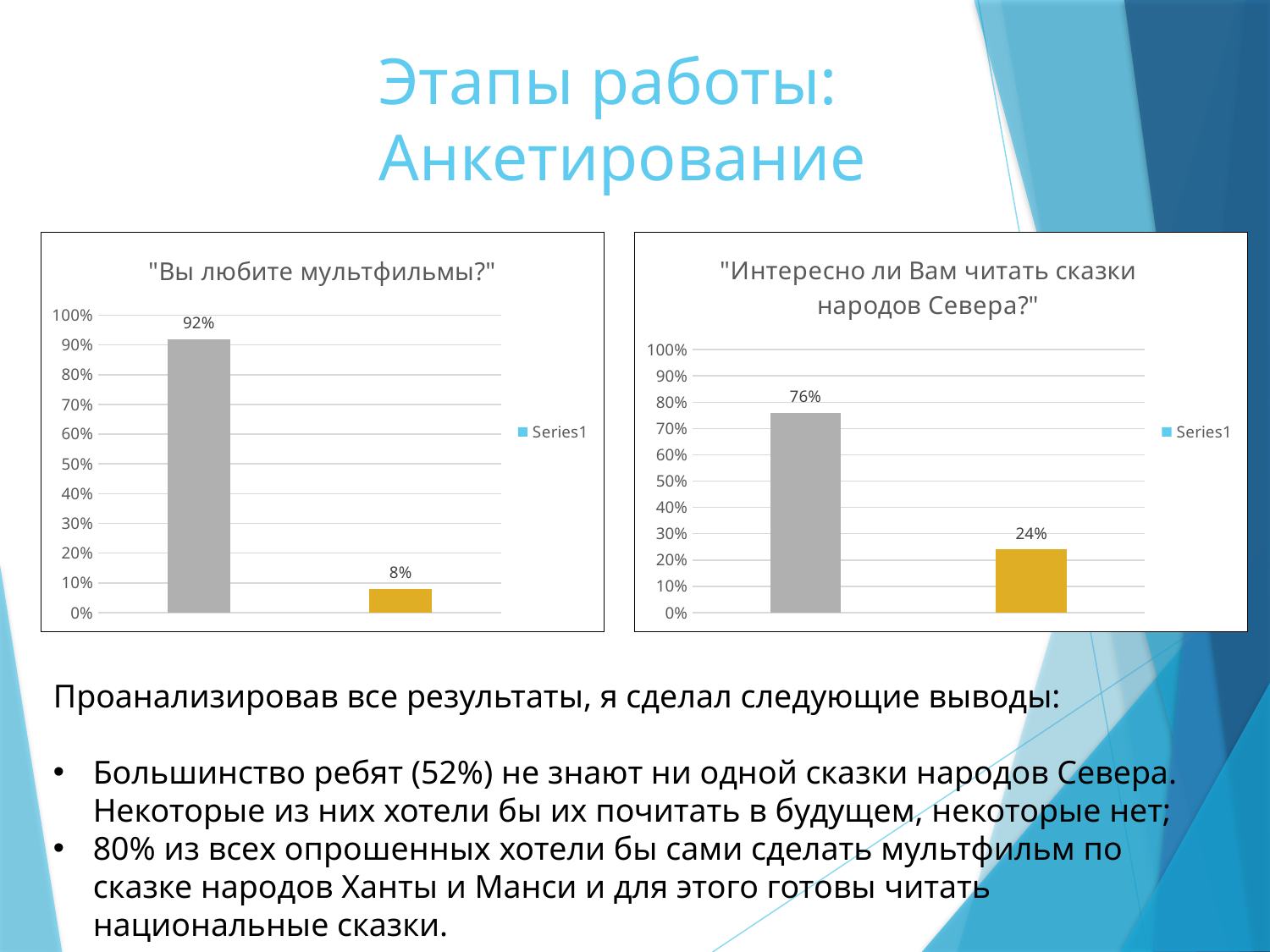
In the chart titled "Вы любите мультфильмы?", what value is shown on the left (gray) bar? 92% In the chart titled "Интересно ли Вам читать сказки народов Севера?", which bar is taller, the gray one or the gold one? the gray one How many bars are plotted in the chart titled "Интересно ли Вам читать сказки народов Севера?"? 2 In the chart titled "Вы любите мультфильмы?", what is the difference between the two bar values? 84% In the chart titled "Вы любите мультфильмы?", is the value of the gold bar greater or less than 10%? less What is the legend entry shown in the chart on the right of the slide? Series1 In the chart titled "Интересно ли Вам читать сказки народов Севера?", what is the difference between the two bar values? 52% In the chart titled "Вы любите мультфильмы?", what value is shown on the right (gold) bar? 8% In the chart titled "Интересно ли Вам читать сказки народов Севера?", what value is shown on the left (gray) bar? 76% In the chart titled "Интересно ли Вам читать сказки народов Севера?", what value is shown on the right (gold) bar? 24% How many series does the legend list in the chart titled "Вы любите мультфильмы?"? 1 What type of chart is the chart on the left of the slide? bar chart